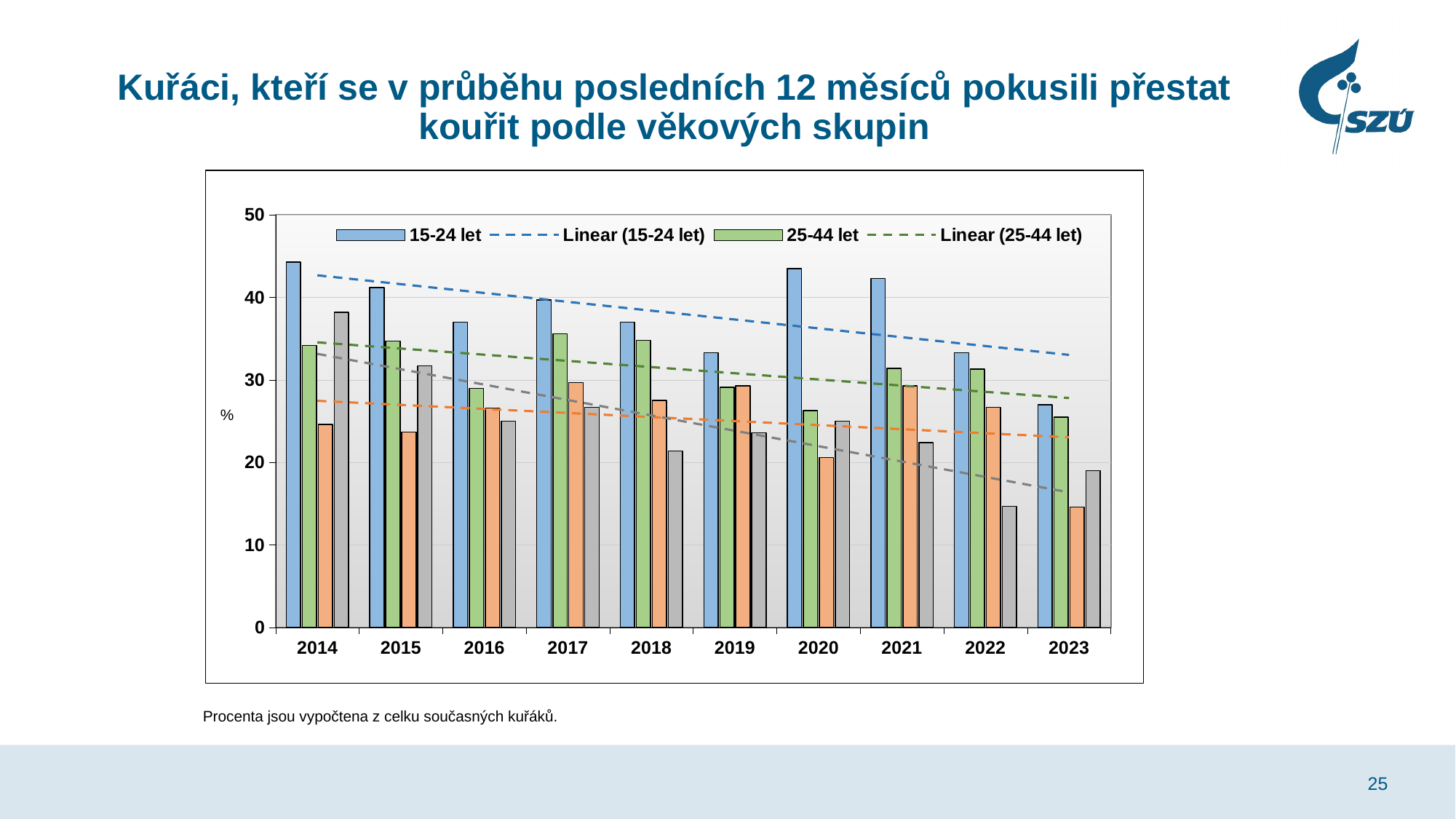
Is the value for 15-24 let in 2019 greater or less than 30? greater What kind of chart is shown on the slide? bar chart Is the value for 25-44 let in 2017 greater or less than 30? greater Is the value for 15-24 let in 2023 greater or less than 30? less In which year is the value for 15-24 let the lowest? 2023 In 2020, which series has the larger value, 15-24 let or 25-44 let? 15-24 let How many years are shown on the x axis of the chart? 10 Does the dashed trend line for 15-24 let rise or fall from 2014 to 2023? fall What unit is shown on the vertical axis of the chart? % How many entries does the chart's legend list? 4